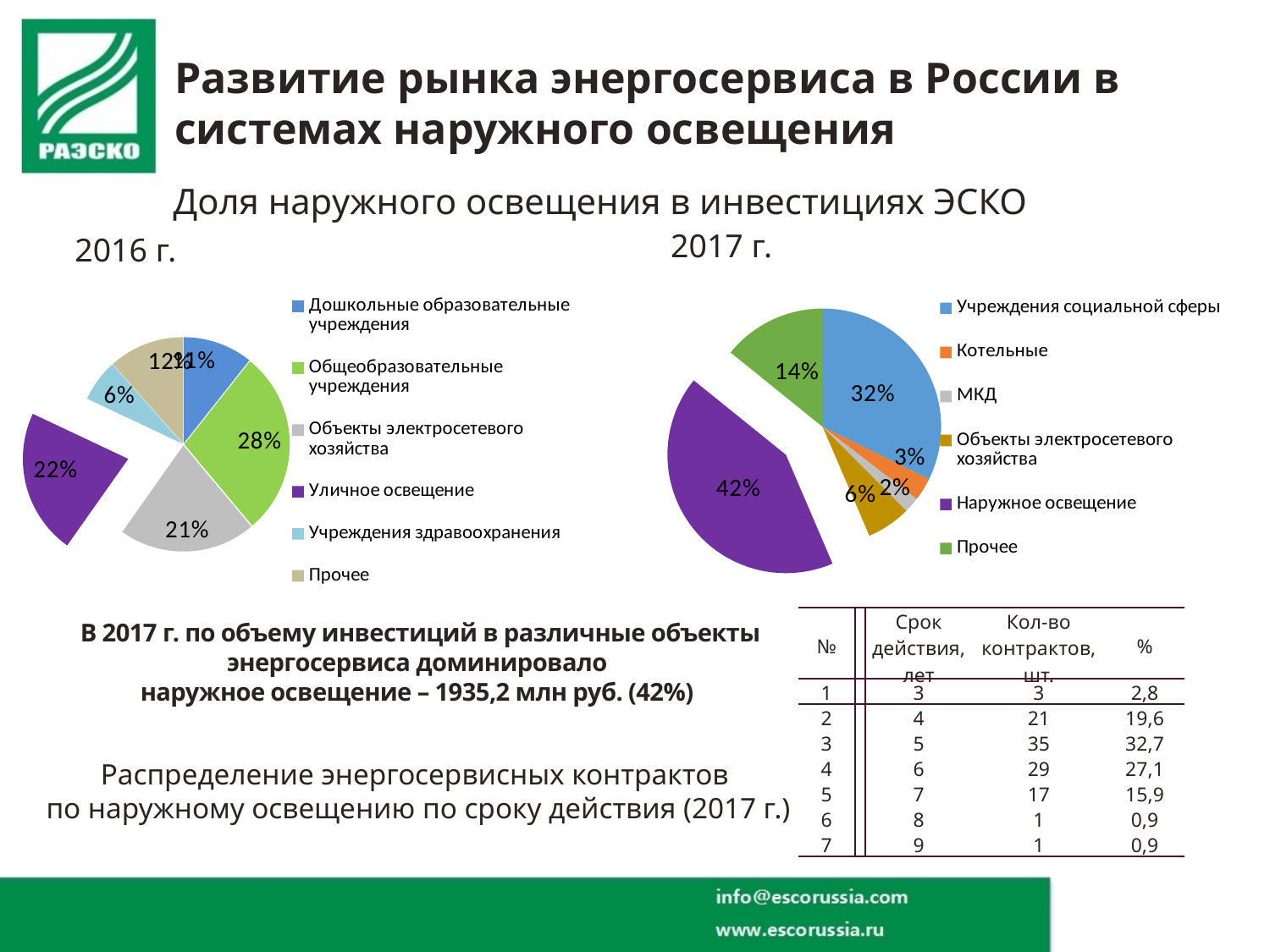
In the 2016 pie chart, what share does Уличное освещение have? 22% In the 2017 pie chart, what is the difference between the shares of Наружное освещение and Учреждения социальной сферы? 10% What type of chart is used for the 2017 data? Pie chart In the 2017 pie chart, what share does Прочее have? 14% In the 2017 pie chart, what share does Учреждения социальной сферы have? 32% In the 2017 pie chart, which category has the largest share? Наружное освещение In the 2016 pie chart, which is larger: Объекты электросетевого хозяйства or Учреждения здравоохранения? Объекты электросетевого хозяйства How many categories does the legend of the 2016 pie chart list? 6 In the 2017 pie chart, what share does Наружное освещение have? 42% In the 2017 pie chart, which category has the smallest share? МКД In the 2017 pie chart, what share does МКД have? 2% In the 2016 pie chart, what share does Общеобразовательные учреждения have? 28%